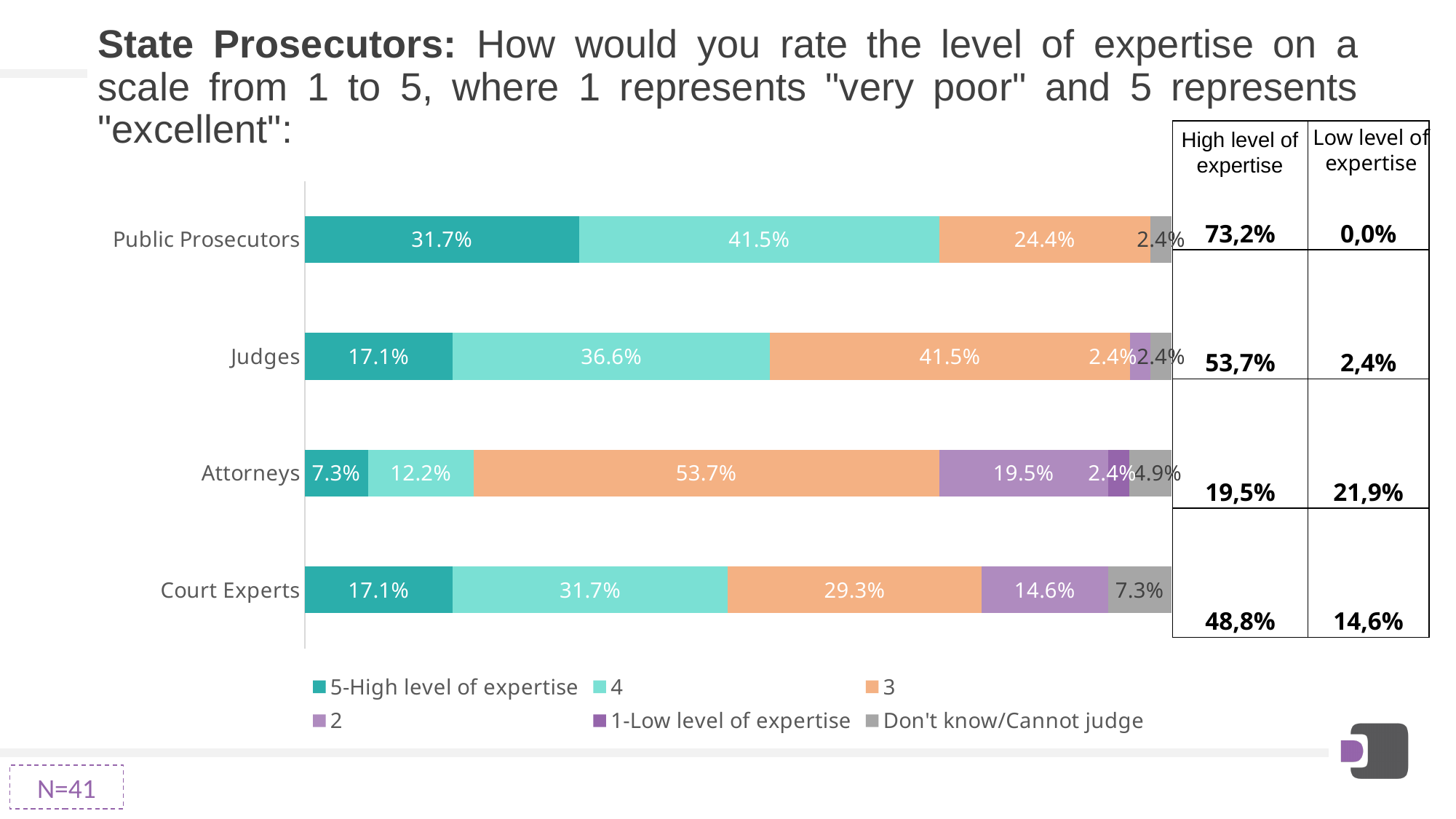
What percentage of respondents answered 'Don't know/Cannot judge' for Judges? 2.4% Which category has the lowest share of 5 (high level of expertise) ratings? Attorneys Which category has the highest share of 5 (high level of expertise) ratings? Public Prosecutors According to the table on the right, what is the 'High level of expertise' value for Court Experts? 48,8% What kind of chart is shown on the slide? Stacked bar chart What percentage of respondents gave Attorneys a rating of 3? 53.7% How many categories are shown on the chart? 4 What percentage of respondents gave Court Experts a rating of 2? 14.6% How many series does the legend list? 6 Which has a larger share of 3 ratings, Judges or Court Experts? Judges What percentage of respondents rated Public Prosecutors with a 5 (high level of expertise)? 31.7% What is the difference between the share of 4 ratings for Public Prosecutors and for Attorneys? 29.3%